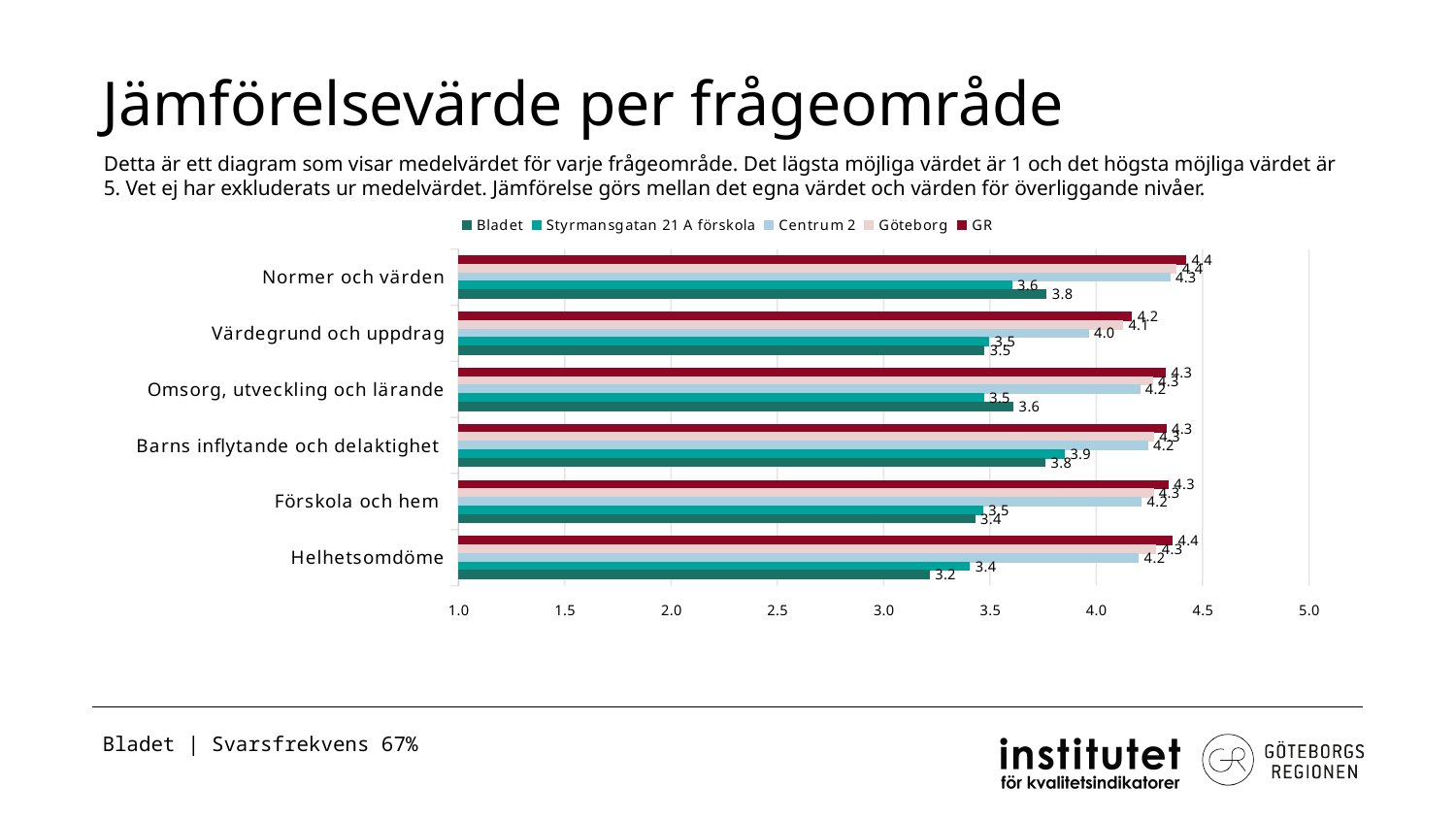
What is the value for Styrmansgatan 21 A förskola in Barns inflytande och delaktighet? 3.9 In which category does Bladet have its lowest value? Helhetsomdöme What kind of chart is shown on the slide? bar chart What is the value for Bladet in Helhetsomdöme? 3.2 How many question areas (categories) are shown on the y axis? 6 What is the difference between Bladet's value in Normer och värden and its value in Helhetsomdöme? 0.6 In which category does Styrmansgatan 21 A förskola have its highest value? Barns inflytande och delaktighet What is the title of the chart slide? Jämförelsevärde per frågeområde For Helhetsomdöme, which is larger: the value for Bladet or the value for Styrmansgatan 21 A förskola? Styrmansgatan 21 A förskola How many series does the legend list? 5 What is the value for Bladet in Normer och värden? 3.8 Is the value for Centrum 2 in Normer och värden greater or less than 4.0? greater